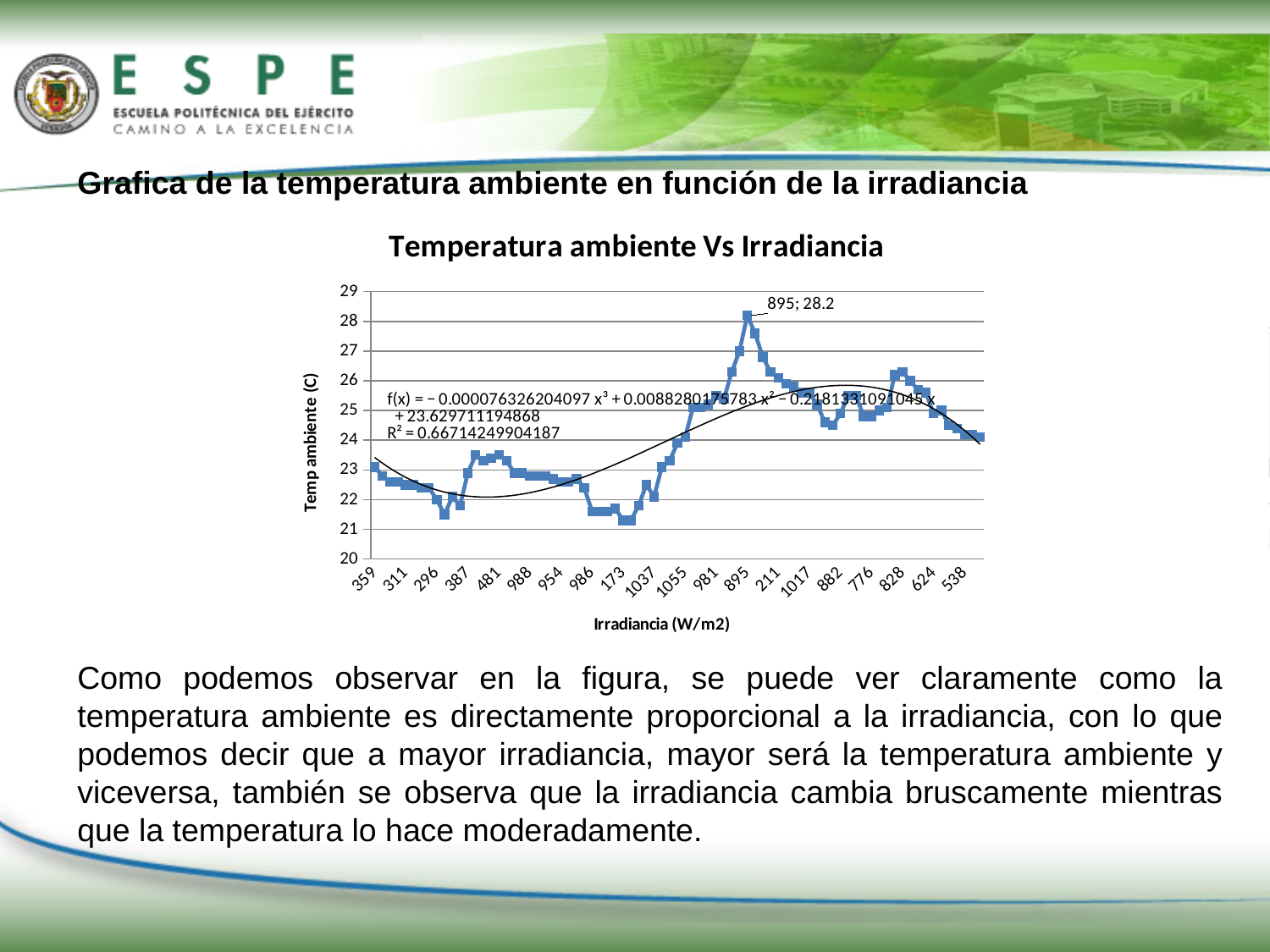
Which is higher, the temperature at irradiance 895 or at irradiance 173? 895 Is the temperature at irradiance 828 greater or less than 25? greater What is the highest temperature value labelled on the chart? 28.2 What temperature is shown by the data label at irradiance 895? 28.2 What is the title of the chart? Temperatura ambiente Vs Irradiancia What kind of chart is shown on the slide? line chart Is the temperature at irradiance 296 greater or less than 23? less At which irradiance value does the chart reach its labelled peak temperature? 895 How many irradiance labels are shown along the x axis? 20 What R² value is printed on the chart for the trendline? 0.66714249904187 Is the temperature at irradiance 538 greater or less than 25? less What is the maximum value shown on the y axis? 29